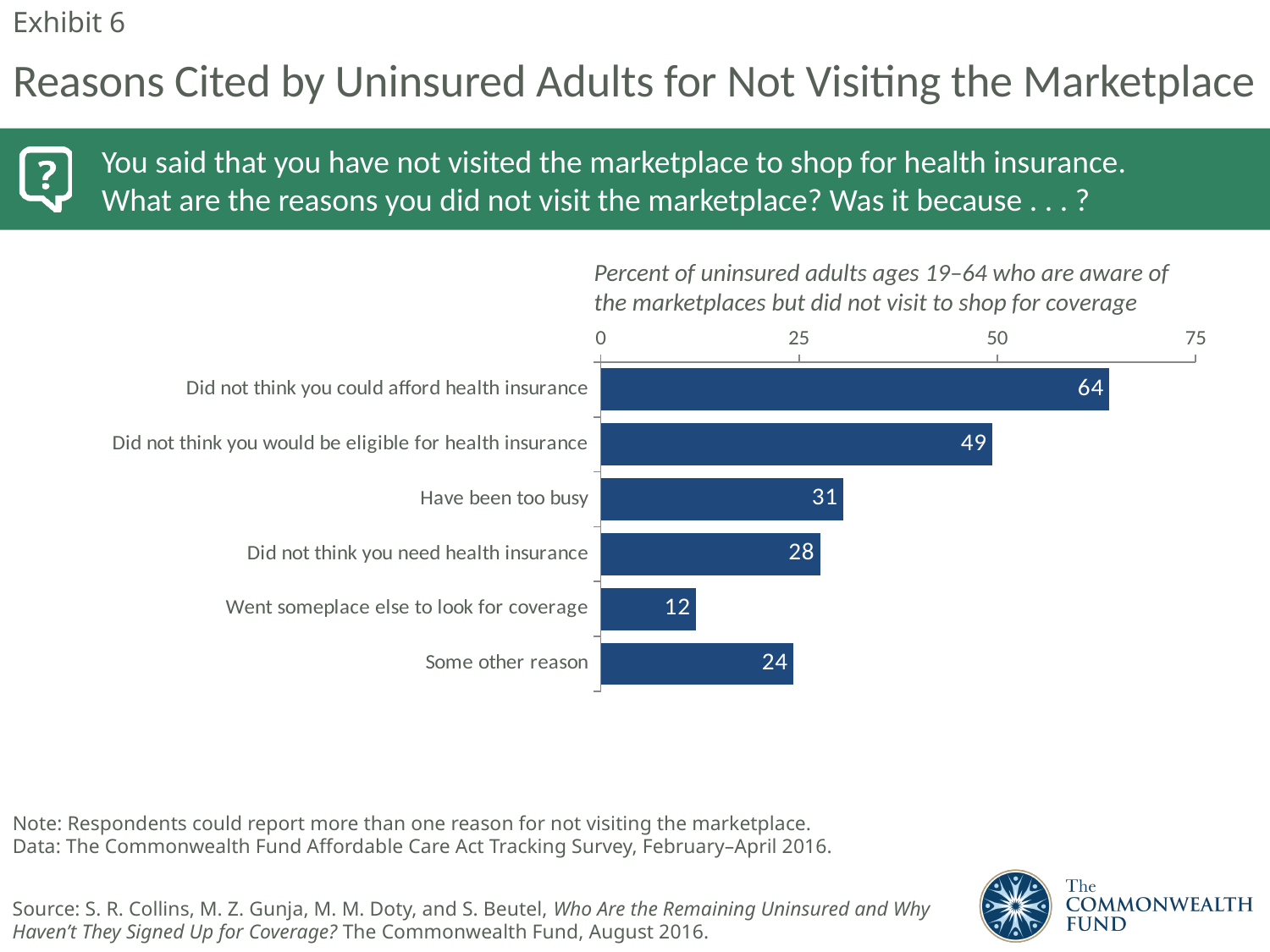
What is the maximum value shown on the chart's axis? 75 What is the difference between "Have been too busy" and "Did not think you need health insurance"? 3 Is the value for "Did not think you would be eligible for health insurance" greater or less than 50? less Which is larger: "Did not think you need health insurance" or "Some other reason"? Did not think you need health insurance What percent of uninsured adults said they did not think they could afford health insurance? 64 What kind of chart is shown on the slide? bar chart What is the difference between "Did not think you could afford health insurance" and "Did not think you would be eligible for health insurance"? 15 What is the value for "Went someplace else to look for coverage"? 12 Which reason has the highest value? Did not think you could afford health insurance What is the value for "Have been too busy"? 31 Which reason has the lowest value? Went someplace else to look for coverage How many reasons are shown in the chart? 6